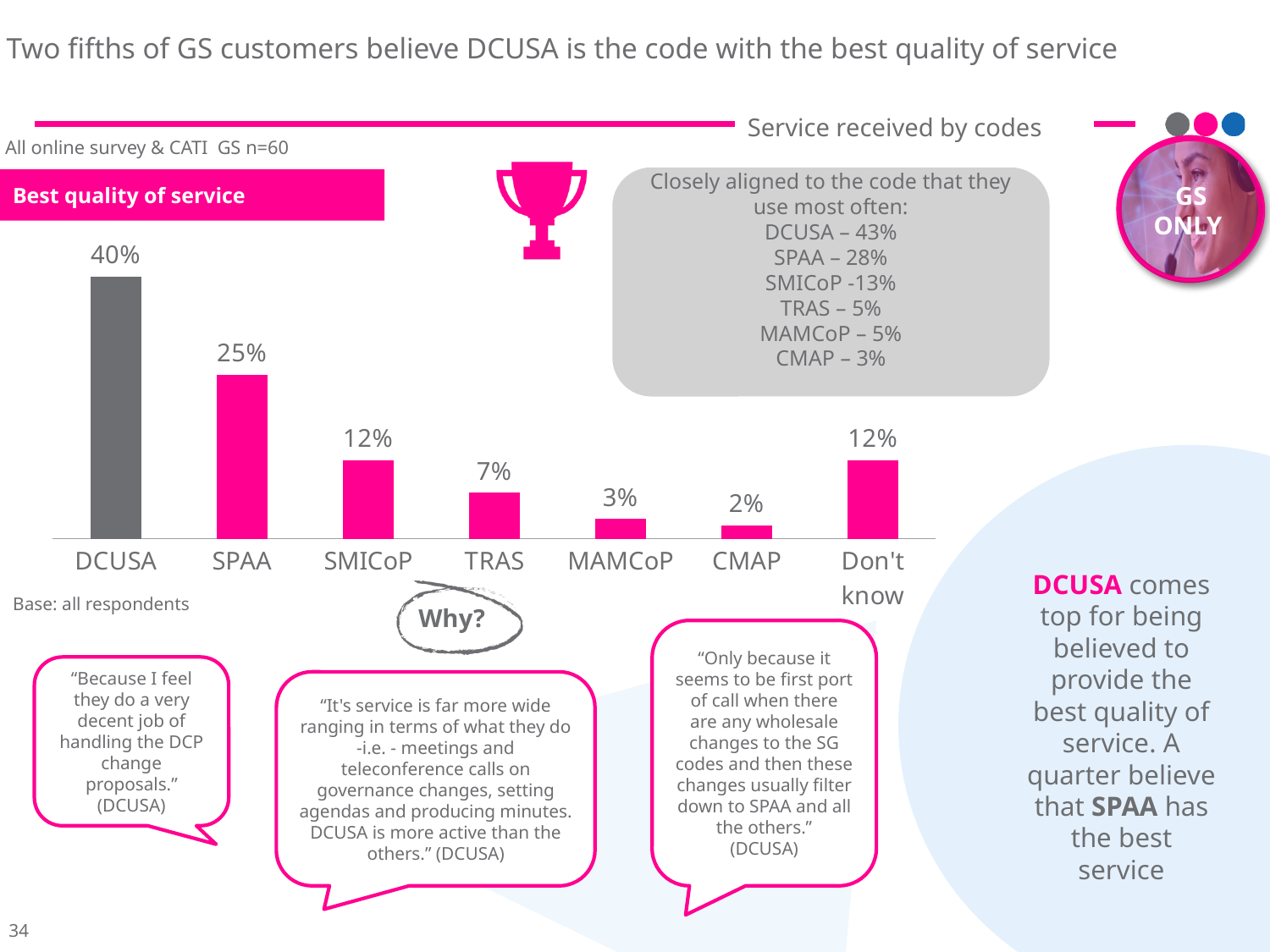
What percentage of GS customers chose DCUSA as having the best quality of service? 40% Which has a larger value, MAMCoP or CMAP? MAMCoP How many categories are shown on the x axis of the chart? 7 What is the difference between the values for DCUSA and SPAA? 15% What is the difference between the values for SMICoP and TRAS? 5% What is the value for TRAS in the chart? 7% Which bar in the chart is coloured grey rather than pink? DCUSA Which code has the highest value in the Best quality of service chart? DCUSA Which code has the lowest value in the Best quality of service chart? CMAP What percentage is shown for the Don't know category? 12% What kind of chart is used to show the Best quality of service results? Bar chart What is the value shown for SPAA in the Best quality of service chart? 25%